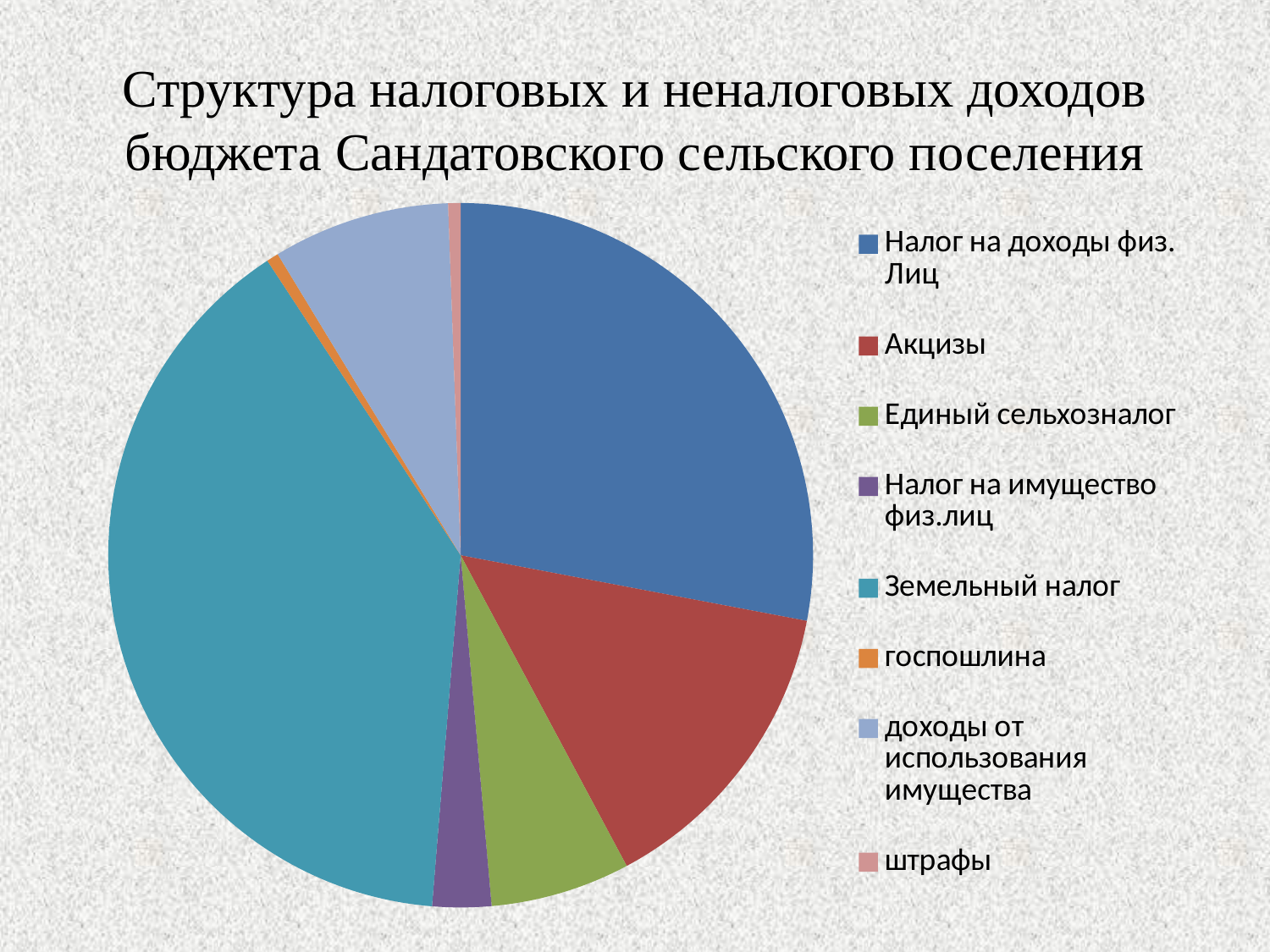
What colour is the slice for Земельный налог? teal What kind of chart is shown on the slide? pie chart Which slice is larger: Земельный налог or Акцизы? Земельный налог Which slice is larger: доходы от использования имущества or госпошлина? доходы от использования имущества Which slice is larger: Акцизы or Единый сельхозналог? Акцизы Which category has the largest slice of the pie? Земельный налог How many categories does the pie chart have? 8 What is the title of the slide? Структура налоговых и неналоговых доходов бюджета Сандатовского сельского поселения